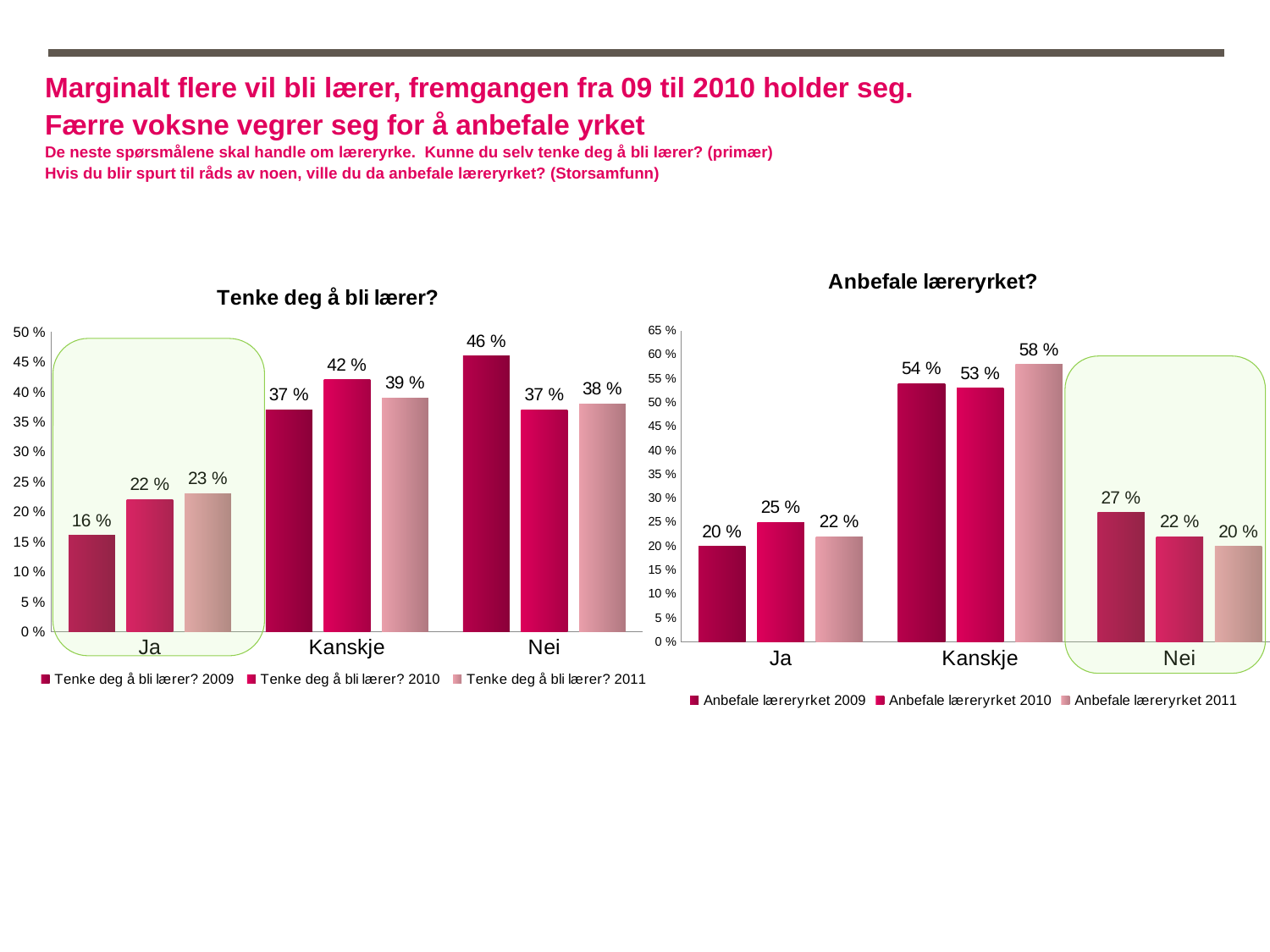
In the 'Tenke deg å bli lærer?' chart, what is the difference between the 2011 and 2009 values for 'Ja'? 7 % In the 'Tenke deg å bli lærer?' chart, which category has the highest value in the 2009 series? Nei In the 'Anbefale læreryrket?' chart, what is the value for 'Nei' in the 2009 series? 27 % In the 'Anbefale læreryrket?' chart, which category has the lowest value in the 2011 series? Nei In the 'Anbefale læreryrket?' chart, what is the value for 'Kanskje' in the 2011 series? 58 % How many categories are shown on the x axis of the 'Tenke deg å bli lærer?' chart? 3 In the 'Anbefale læreryrket?' chart, which is larger for 'Ja': the 2010 value or the 2011 value? 2010 In the 'Anbefale læreryrket?' chart, what is the difference between the 2009 and 2011 values for 'Nei'? 7 % What kind of chart is the 'Anbefale læreryrket?' chart? Bar chart In the 'Tenke deg å bli lærer?' chart, what is the value for 'Nei' in the 2009 series? 46 % In the 'Tenke deg å bli lærer?' chart, what is the value for 'Ja' in the 2011 series? 23 % How many series does the legend of the 'Anbefale læreryrket?' chart list? 3